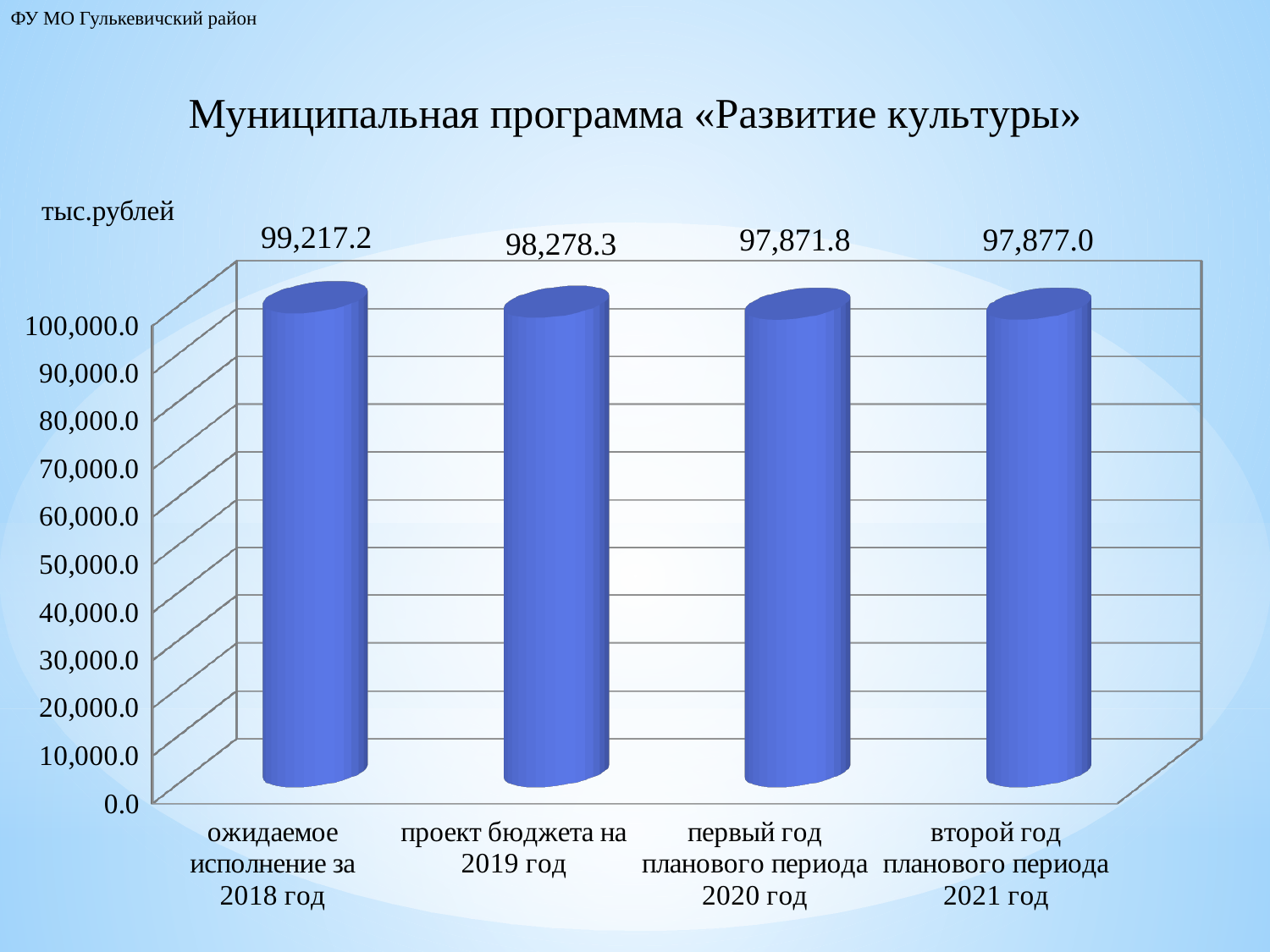
Is the value for «проект бюджета на 2019 год» greater or less than 100,000.0? less What is the value for «первый год планового периода 2020 год»? 97,871.8 How many categories are shown on the chart? 4 What is the value for «ожидаемое исполнение за 2018 год»? 99,217.2 What is the value for «второй год планового периода 2021 год»? 97,877.0 What is the value for «проект бюджета на 2019 год»? 98,278.3 Which is larger: the value for 2018 (ожидаемое исполнение) or the value for 2021 (второй год планового периода)? ожидаемое исполнение за 2018 год What is the difference between the value for 2021 and the value for 2020? 5.2 Which category has the highest value? ожидаемое исполнение за 2018 год What is the difference between the value for 2018 (ожидаемое исполнение) and the value for 2019 (проект бюджета)? 938.9 What kind of chart is shown on the slide? bar chart Which category has the lowest value? первый год планового периода 2020 год